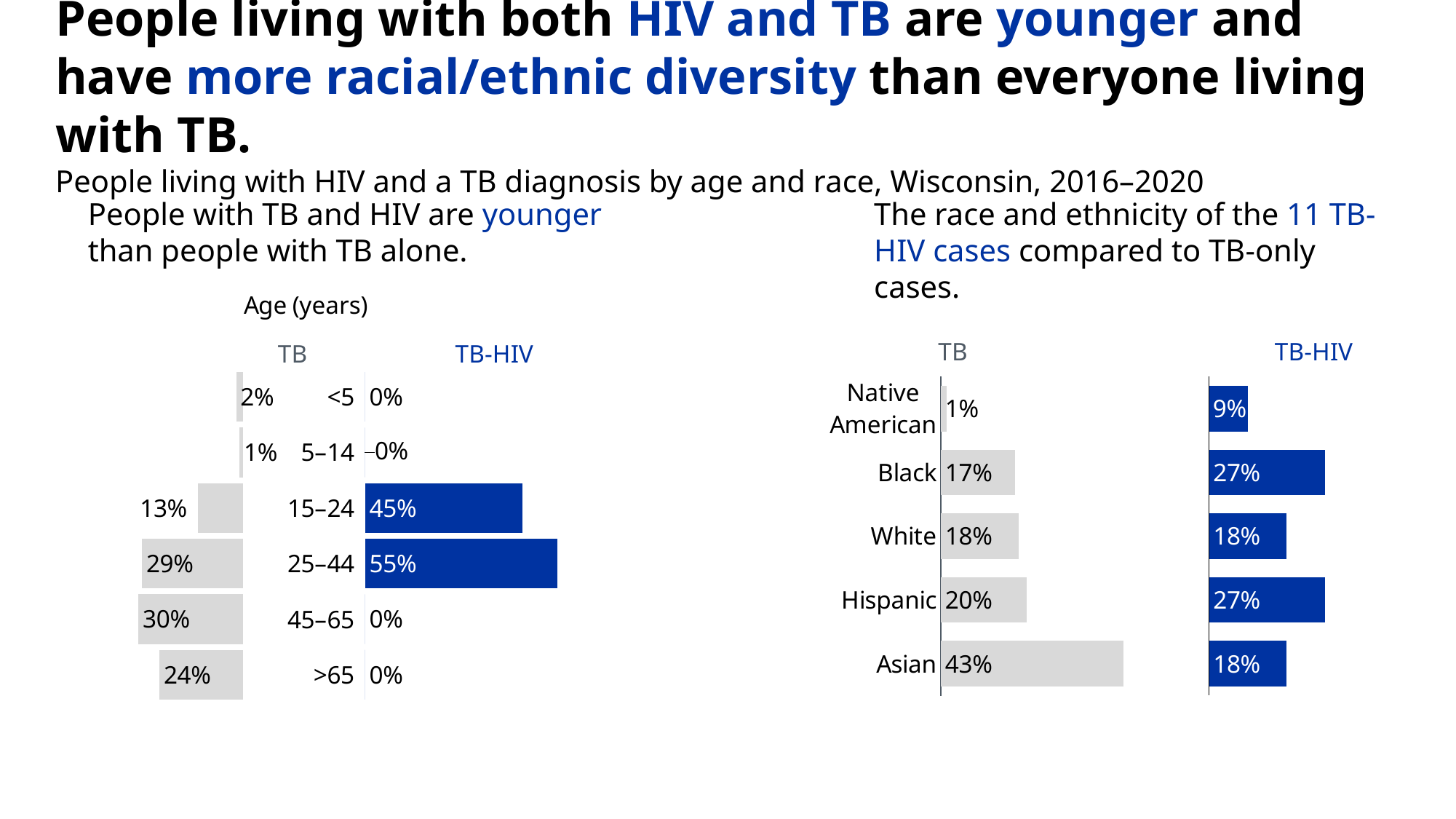
In the left chart (age), which age group has the lowest percentage of TB cases? 5–14 In the left chart (age), what is the difference between the TB-HIV and TB percentages for the 15–24 age group? 32% In the left chart (age), what percentage of TB-HIV cases are aged 25–44? 55% In the right chart (race and ethnicity), is the TB-HIV percentage for Black cases larger or smaller than the TB percentage for Black cases? larger In the left chart (age), what percentage of TB cases are aged 45–65? 30% In the left chart (age), which age group has the highest percentage of TB-HIV cases? 25–44 In the left chart (age), how many age groups are shown? 6 In the right chart (race and ethnicity), what percentage of TB cases are Asian? 43% In the right chart (race and ethnicity), which group has the highest percentage of TB cases? Asian What type of chart is used on the slide to show the age and race distributions? Bar chart In the right chart (race and ethnicity), what percentage of TB-HIV cases are Native American? 9% In the right chart (race and ethnicity), what is the difference between the TB and TB-HIV percentages for Asian cases? 25%